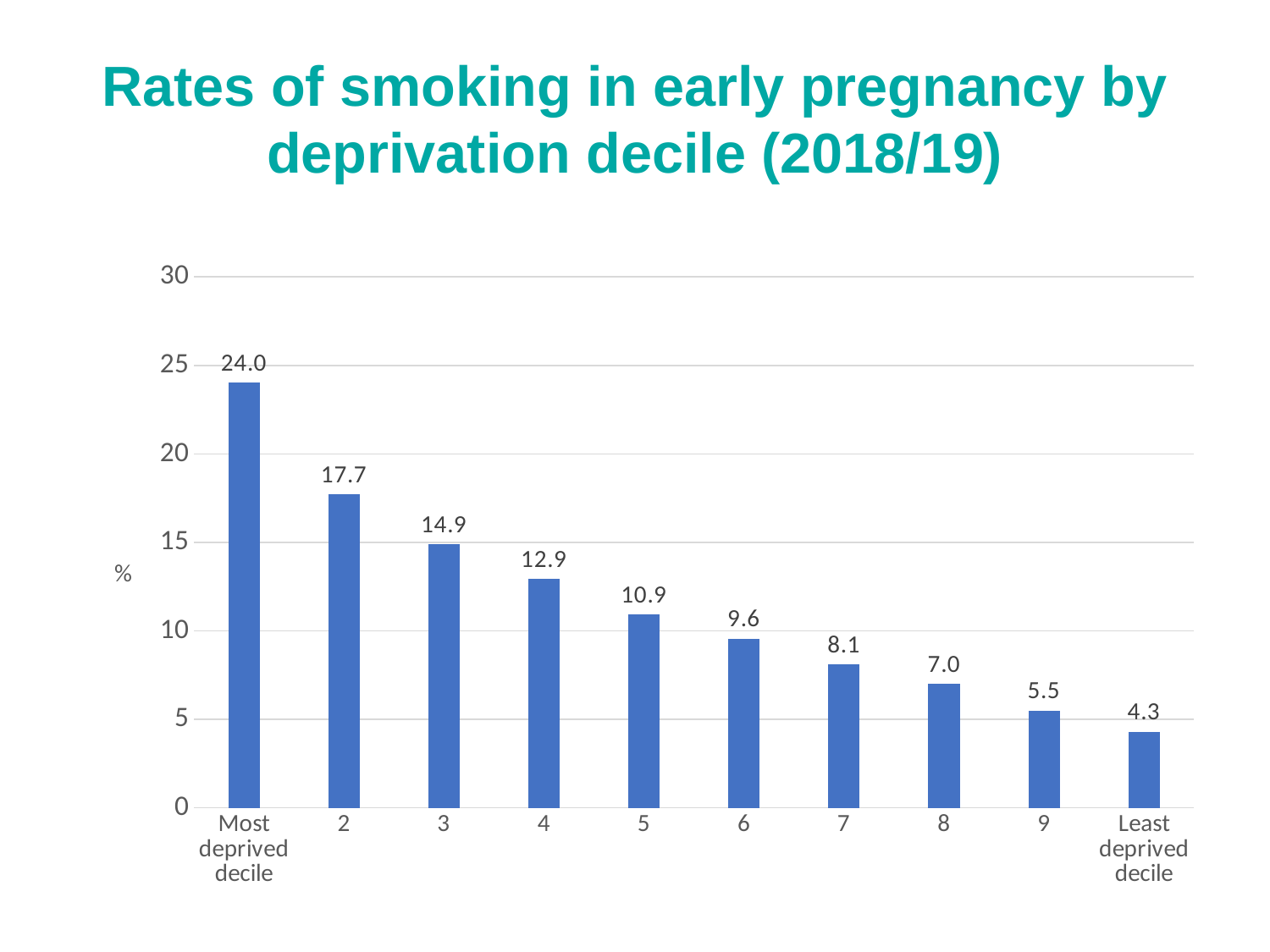
What is the difference between the smoking rates of the most deprived decile and the least deprived decile? 19.7 Which decile has the lowest smoking rate? Least deprived decile What is the smoking rate for decile 5? 10.9 What is the smoking rate for the least deprived decile? 4.3 Do the smoking rates rise or fall from the most deprived decile to the least deprived decile? Fall Which has a higher smoking rate, decile 4 or decile 7? Decile 4 What is the label on the vertical axis of the chart? % What is the smoking rate for the most deprived decile? 24.0 How many deciles are shown on the chart? 10 What is the difference between the smoking rates of decile 2 and decile 3? 2.8 What kind of chart is shown on the slide? Bar chart Which decile has the highest smoking rate? Most deprived decile